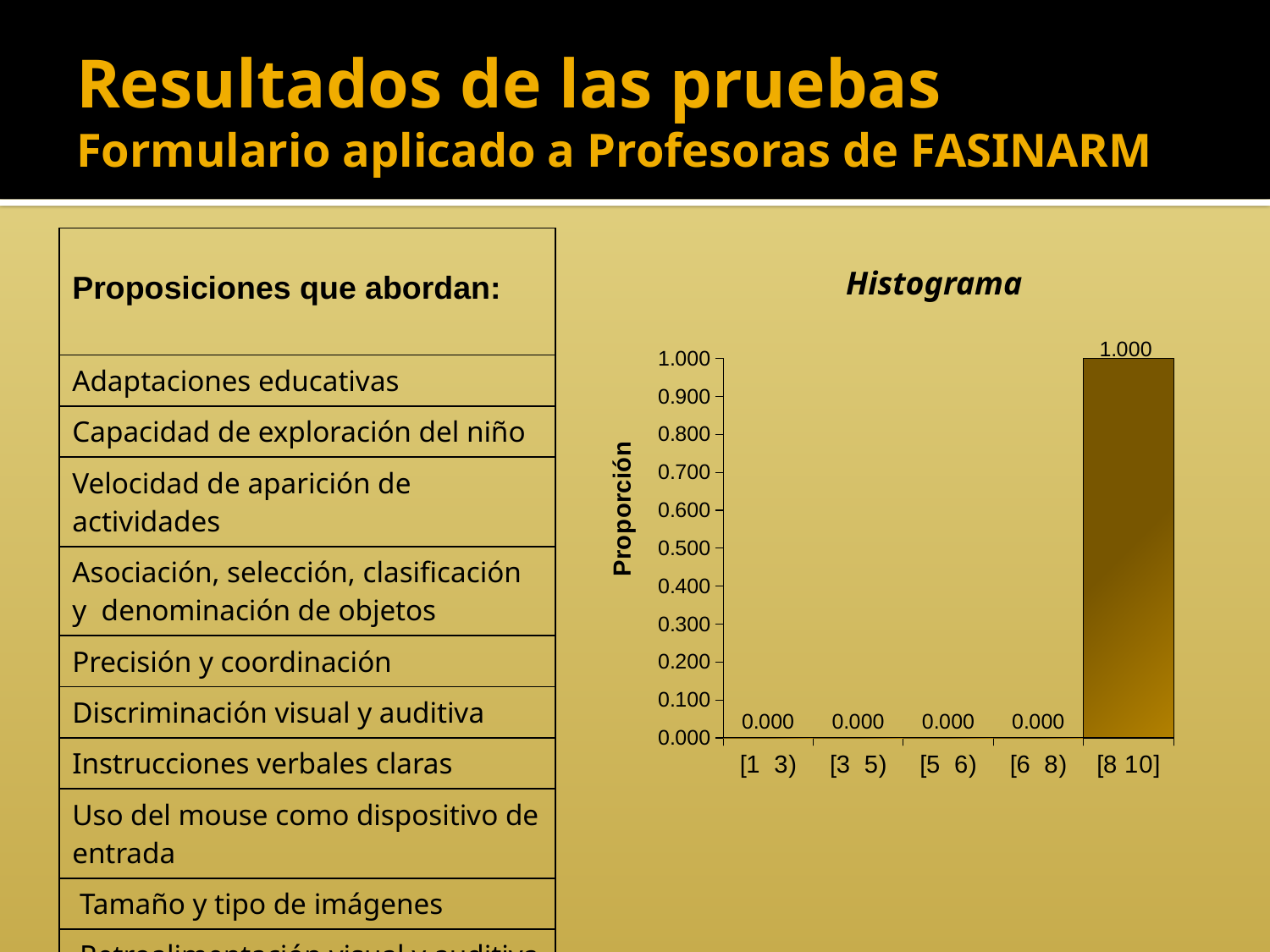
What is the difference between the values for [8 10] and [6 8)? 1.000 What is the value for the [8 10] category? 1.000 Which category has the highest value? [8 10] What is the value for the [5 6) category? 0.000 Is the value for [8 10] greater or less than 0.500? greater How many categories are shown on the x axis of the chart? 5 Do the values rise or fall from left to right along the x axis? rise What is the label of the y axis? Proporción What is the title of the chart? Histograma What type of chart is shown on the slide? bar chart Which is larger, the value for [3 5) or the value for [8 10]? [8 10] What is the value for the [1 3) category? 0.000